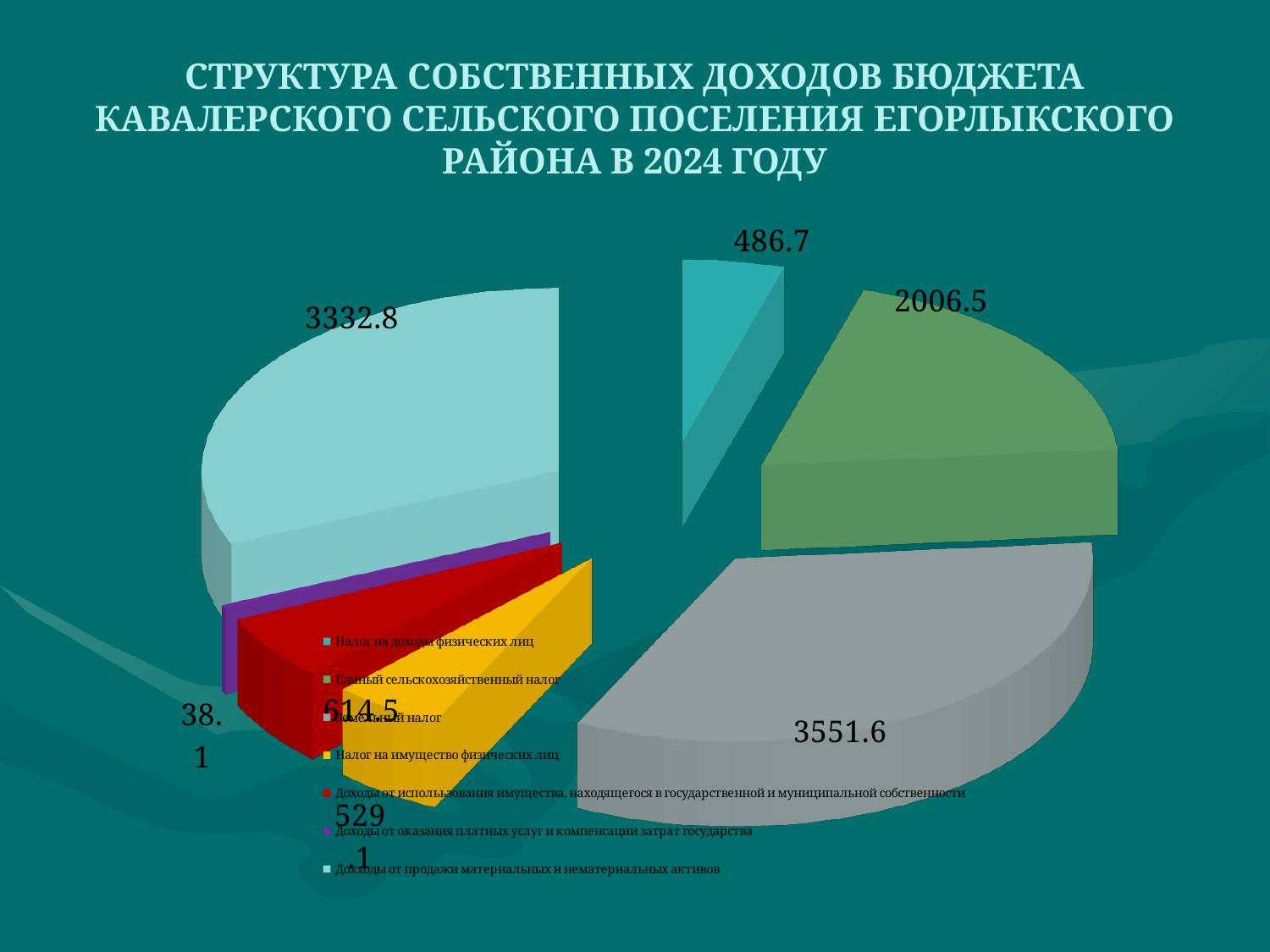
What is the difference between the values for Земельный налог and Доходы от продажи материальных и нематериальных активов? 218.8 What type of chart is shown on the slide? Pie chart What is the value shown for Земельный налог? 3551.6 What is the value shown for Налог на доходы физических лиц? 486.7 Which year does the chart title say the budget revenue structure refers to? 2024 How many categories does the legend of the pie chart list? 7 What is the value shown for Единый сельскохозяйственный налог? 2006.5 Which category has the largest slice of the pie? Земельный налог What is the value shown for Доходы от оказания платных услуг и компенсации затрат государства? 38.1 Which is larger: the value for Единый сельскохозяйственный налог or the value for Налог на доходы физических лиц? Единый сельскохозяйственный налог Which category has the smallest slice of the pie? Доходы от оказания платных услуг и компенсации затрат государства What is the value shown for Доходы от продажи материальных и нематериальных активов? 3332.8